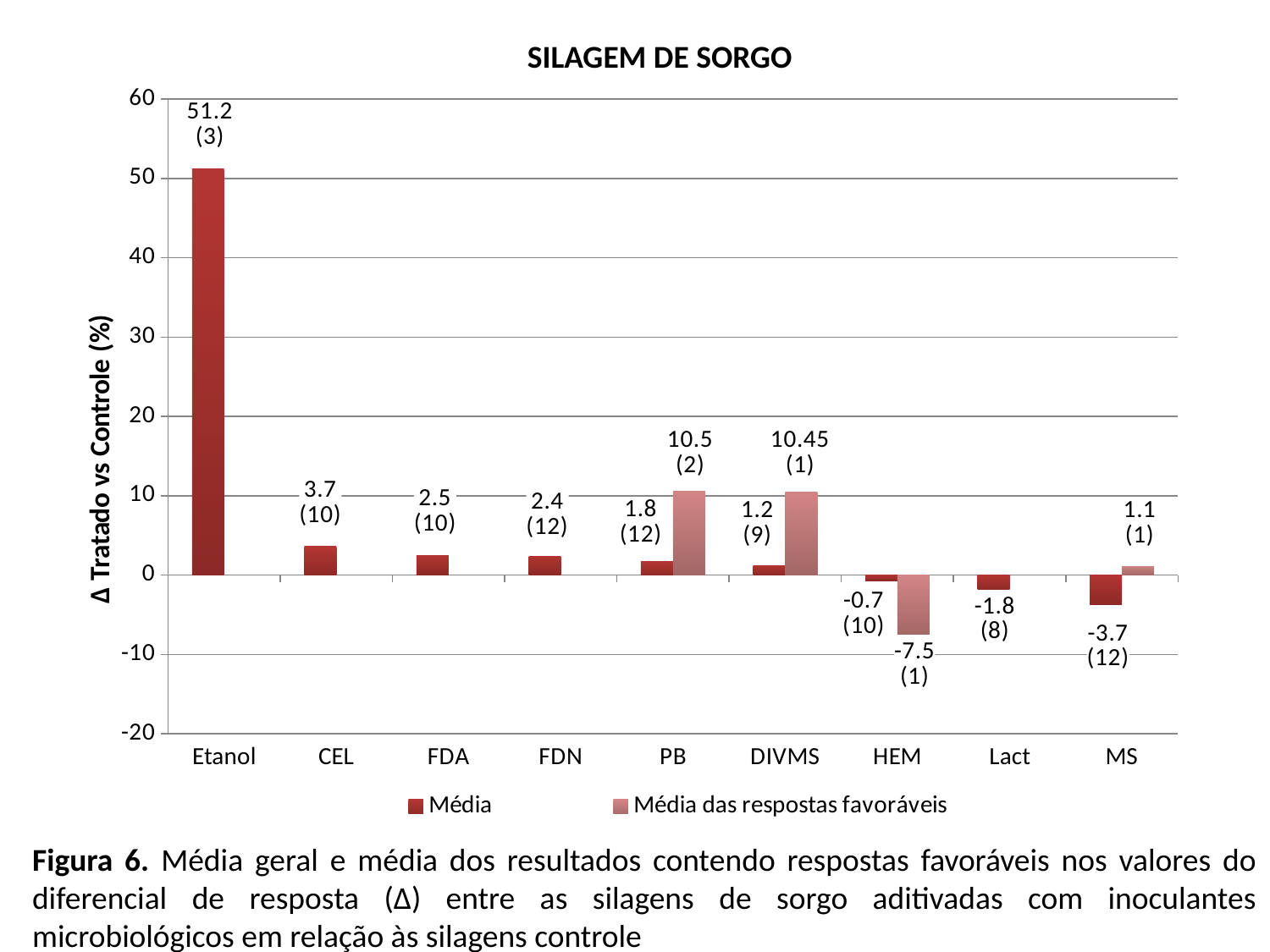
What is the Média value for Etanol? 51.2 What is the Média value for MS? -3.7 What is the difference between the Média value for CEL and the Média value for FDA? 1.2 What is the Média das respostas favoráveis value for HEM? -7.5 Which category has the highest Média value? Etanol Which category has the lowest Média value? MS Is the Média value for Etanol greater or less than 50? greater How many series does the legend list? 2 What is the Média das respostas favoráveis value for PB? 10.5 Which is larger, the Média value for FDN or the Média value for PB? FDN What kind of chart is shown on the slide? bar chart How many categories are shown on the x axis? 9